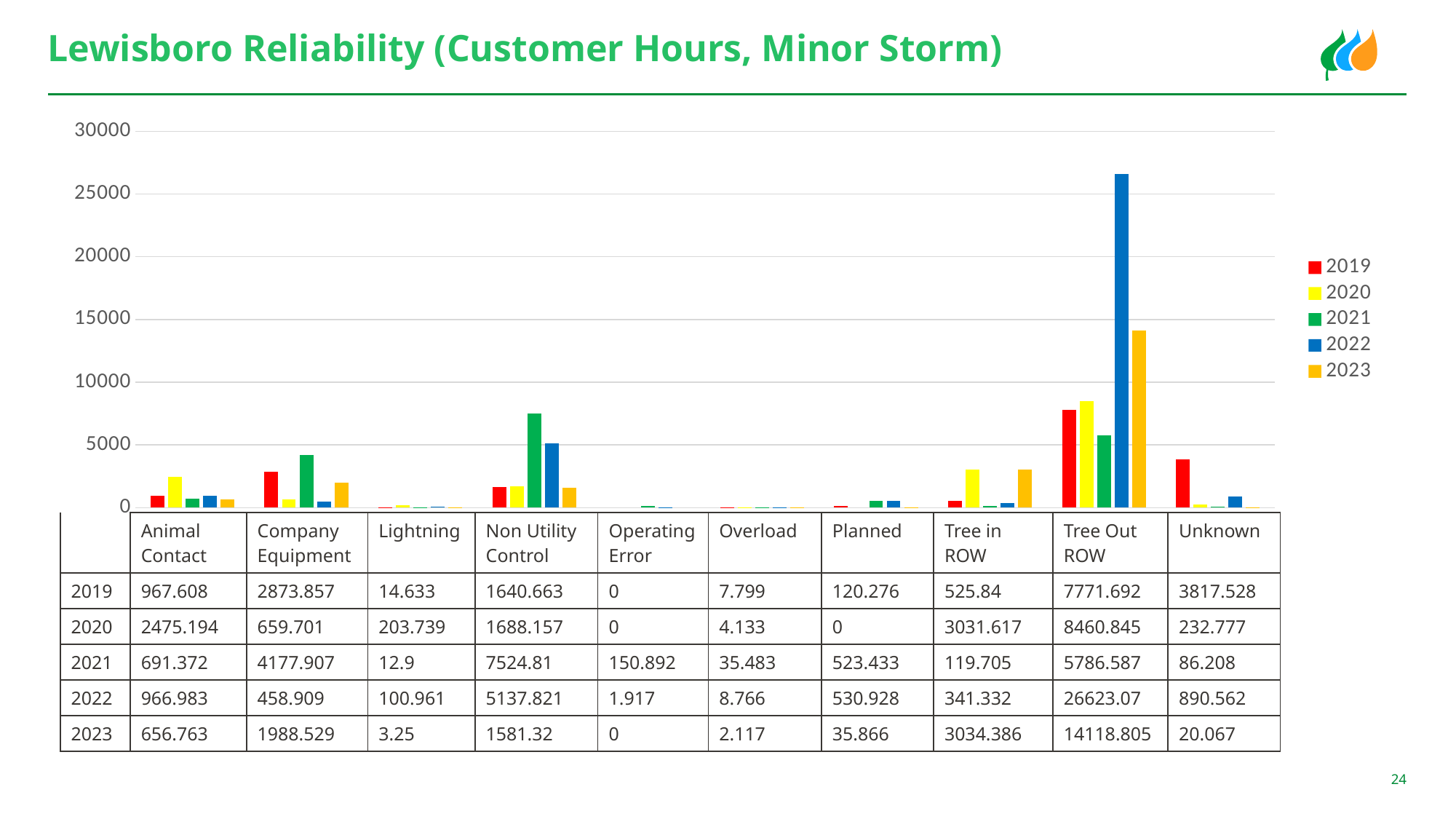
How many series does the legend list? 5 Which year has the highest value for Tree Out ROW? 2022 What is the value for Tree Out ROW in 2022? 26623.07 What type of chart is shown on the slide? bar chart What is the title of the chart? Lewisboro Reliability (Customer Hours, Minor Storm) What is the value for Non Utility Control in 2021? 7524.81 Which category has the highest value for 2019? Tree Out ROW What is the value for Animal Contact in 2020? 2475.194 Which is larger: Unknown in 2019 or Tree in ROW in 2020? Unknown in 2019 Is the value for Tree Out ROW in 2022 greater or less than 25000? greater How many categories are shown on the x axis? 10 What is the difference between the Tree Out ROW values for 2022 and 2023? 12504.265